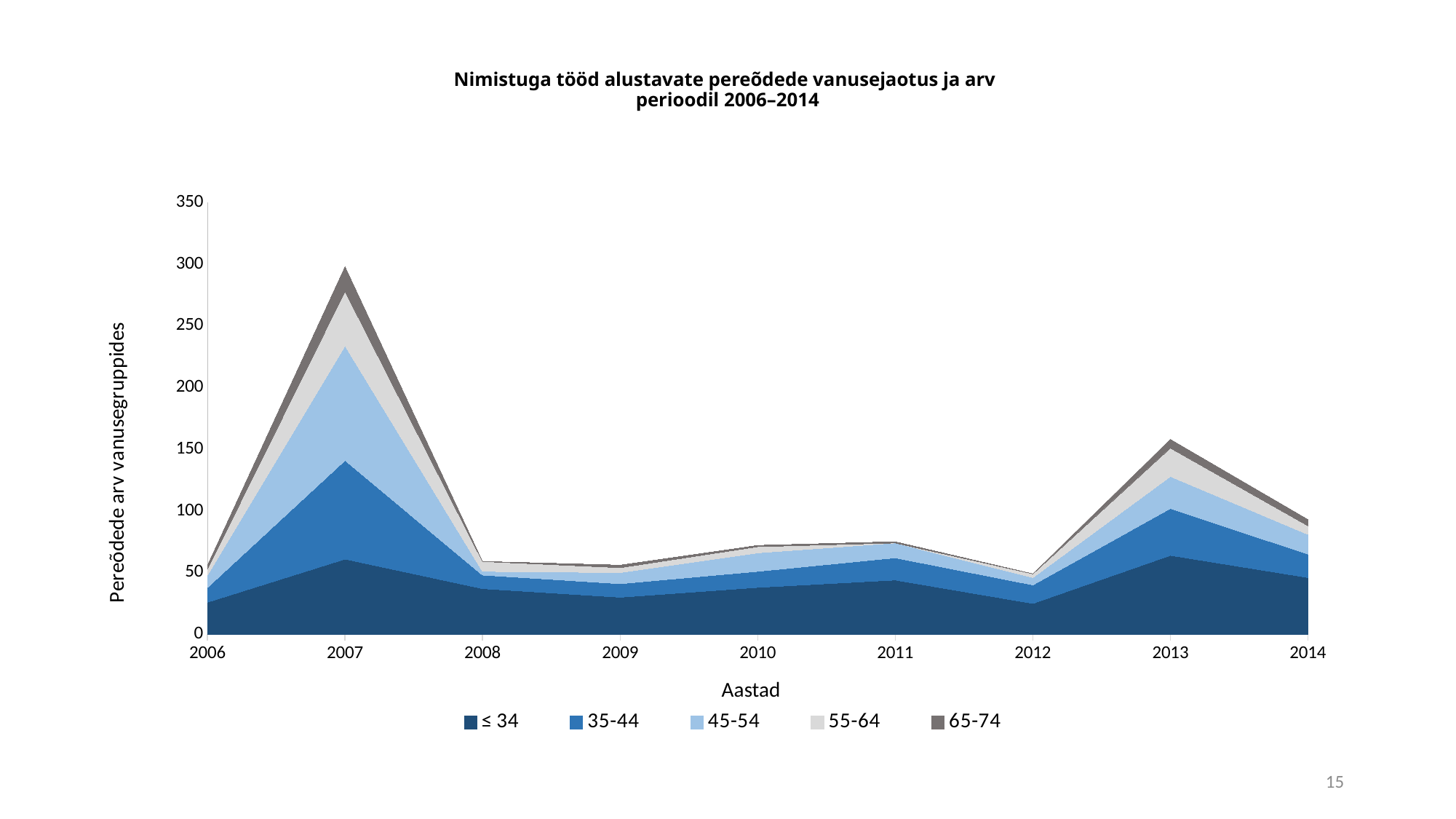
Is the total value for 2012 greater or less than 100? less What is the label of the x axis? Aastad Which year has a larger total, 2013 or 2014? 2013 How many series does the legend list? 5 In which year is the total number of family doctors highest? 2007 What kind of chart is shown on the slide? Stacked area chart Is the total value for 2007 greater or less than 250? greater Is the total value for 2013 greater or less than 100? greater Does the total rise or fall from 2007 to 2008? Fall Which year has a larger total, 2007 or 2013? 2007 How many years are plotted along the x axis? 9